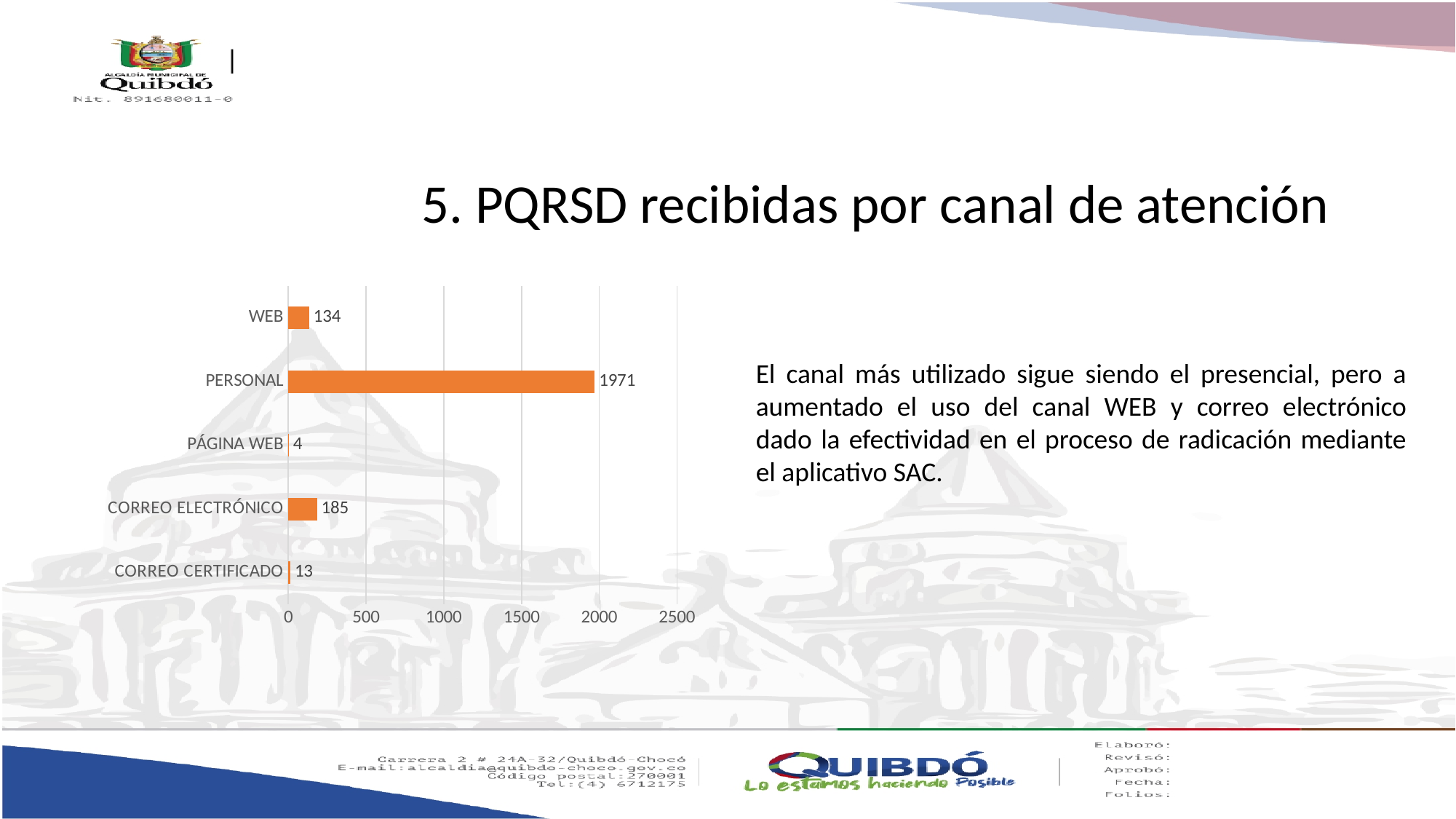
What is the value for CORREO CERTIFICADO? 13 What is the title of the slide containing the chart? 5. PQRSD recibidas por canal de atención Which channel has the highest value? PERSONAL What kind of chart is shown on the slide? bar chart What is the value for CORREO ELECTRÓNICO? 185 What is the value for PERSONAL? 1971 Which channel has the lowest value? PÁGINA WEB What is the difference between the values for PERSONAL and CORREO ELECTRÓNICO? 1786 What is the value for WEB? 134 Which is larger, the value for WEB or the value for CORREO ELECTRÓNICO? CORREO ELECTRÓNICO How many channels are shown in the chart? 5 Is the value for PERSONAL greater or less than 1500? greater